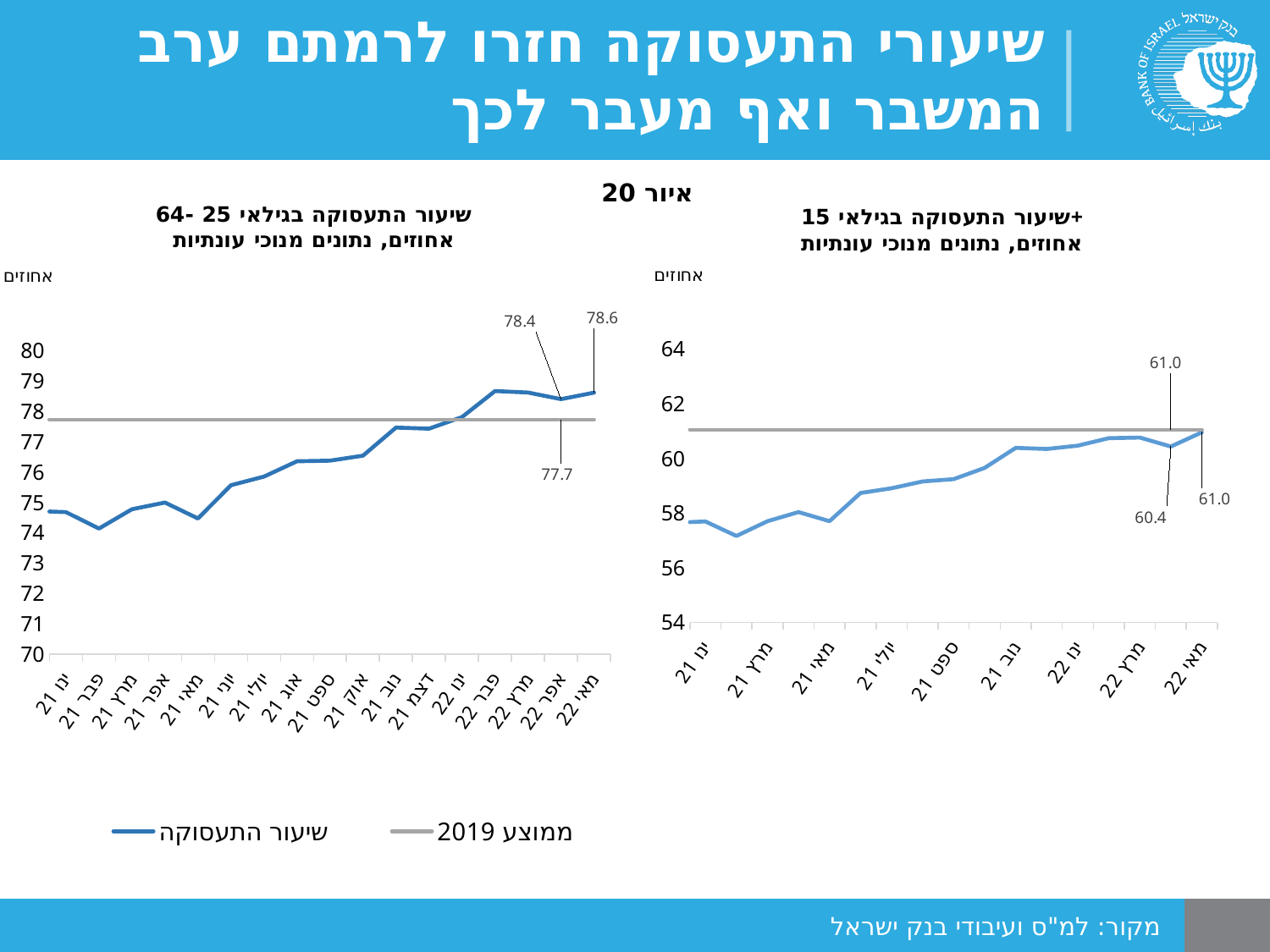
What type of chart is used on this slide? line chart In the right chart (employment rate ages 15+), is the value for November 2021 (נוב 21) greater or less than 60? greater In the left chart (employment rate ages 25-64), which month has the lowest employment rate? פבר 21 (February 2021) In the left chart (employment rate ages 25-64), what is the employment rate for May 2022 (מאי 22)? 78.6 In the left chart (employment rate ages 25-64), is the value for February 2021 (פבר 21) greater or less than 75? less In the left chart (employment rate ages 25-64), what is the 2019 average (ממוצע 2019) shown by the grey line? 77.7 In the right chart (employment rate ages 15+), what is the difference between the last labelled value (61.0) and the previous labelled value (60.4)? 0.6 In the right chart (employment rate ages 15+), what is the 2019 average shown by the grey line? 61.0 In the left chart (employment rate ages 25-64), by how much does the May 2022 value (78.6) exceed the 2019 average (77.7)? 0.9 In the right chart (employment rate ages 15+), which is larger: the April 2022 value (60.4) or the 2019 average (61.0)? the 2019 average (61.0) In the right chart (employment rate ages 15+), what is the employment rate for April 2022, the labelled point just before the last one? 60.4 How many series does the legend list? 2